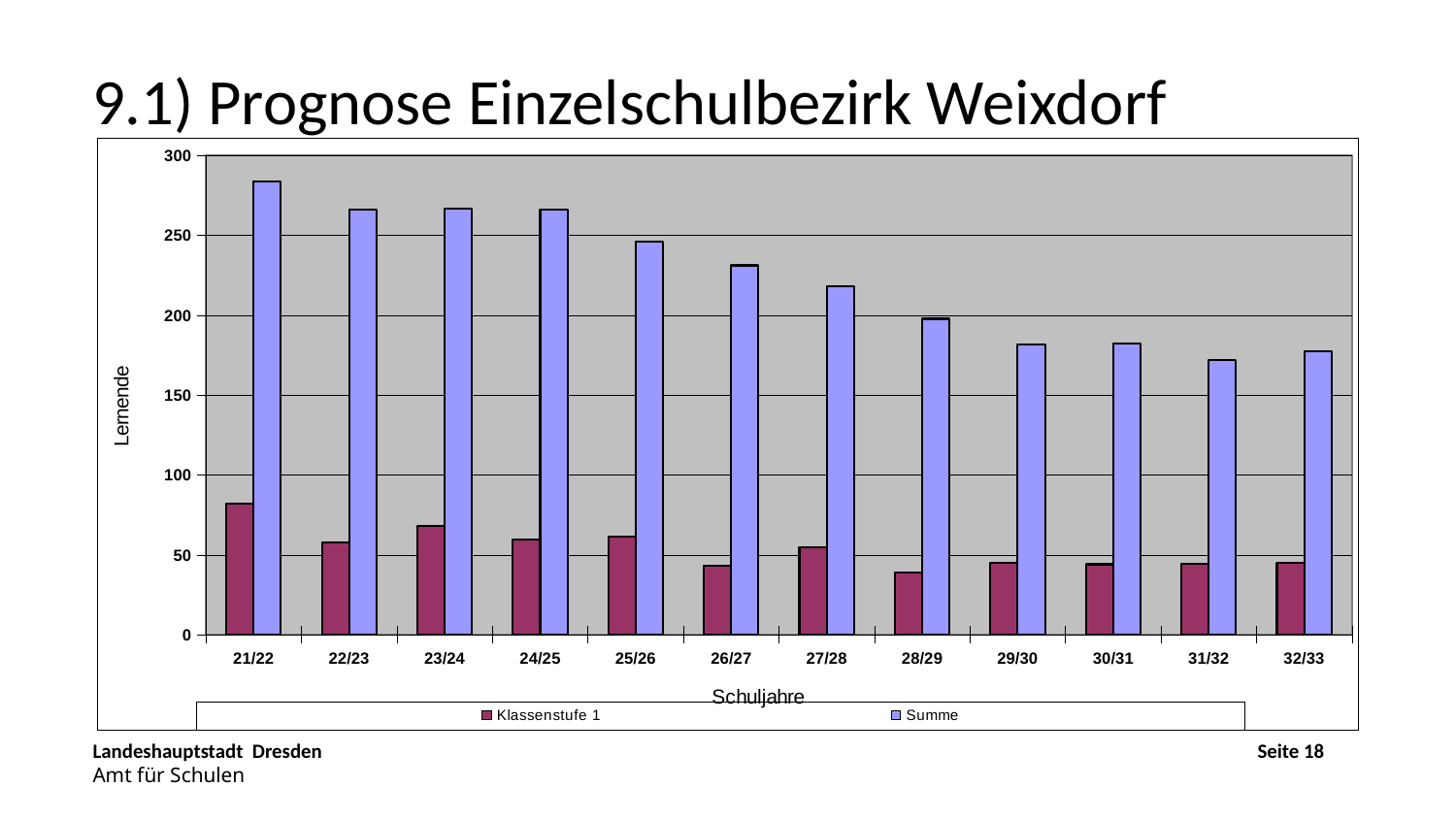
How many school years (categories) are shown on the x axis? 12 Which school year has the highest value for Klassenstufe 1? 21/22 Is the Summe value for 31/32 greater or less than 200? less Is the Klassenstufe 1 value for 21/22 greater or less than 50? greater How many series does the legend list? 2 Is the Klassenstufe 1 value for 28/29 greater or less than 50? less Do the Summe values generally rise or fall from 21/22 to 32/33? fall What kind of chart is shown on the slide? bar chart What is the label of the vertical axis? Lernende Which school year has the highest value for Summe? 21/22 Which is larger, the Summe value for 21/22 or for 26/27? 21/22